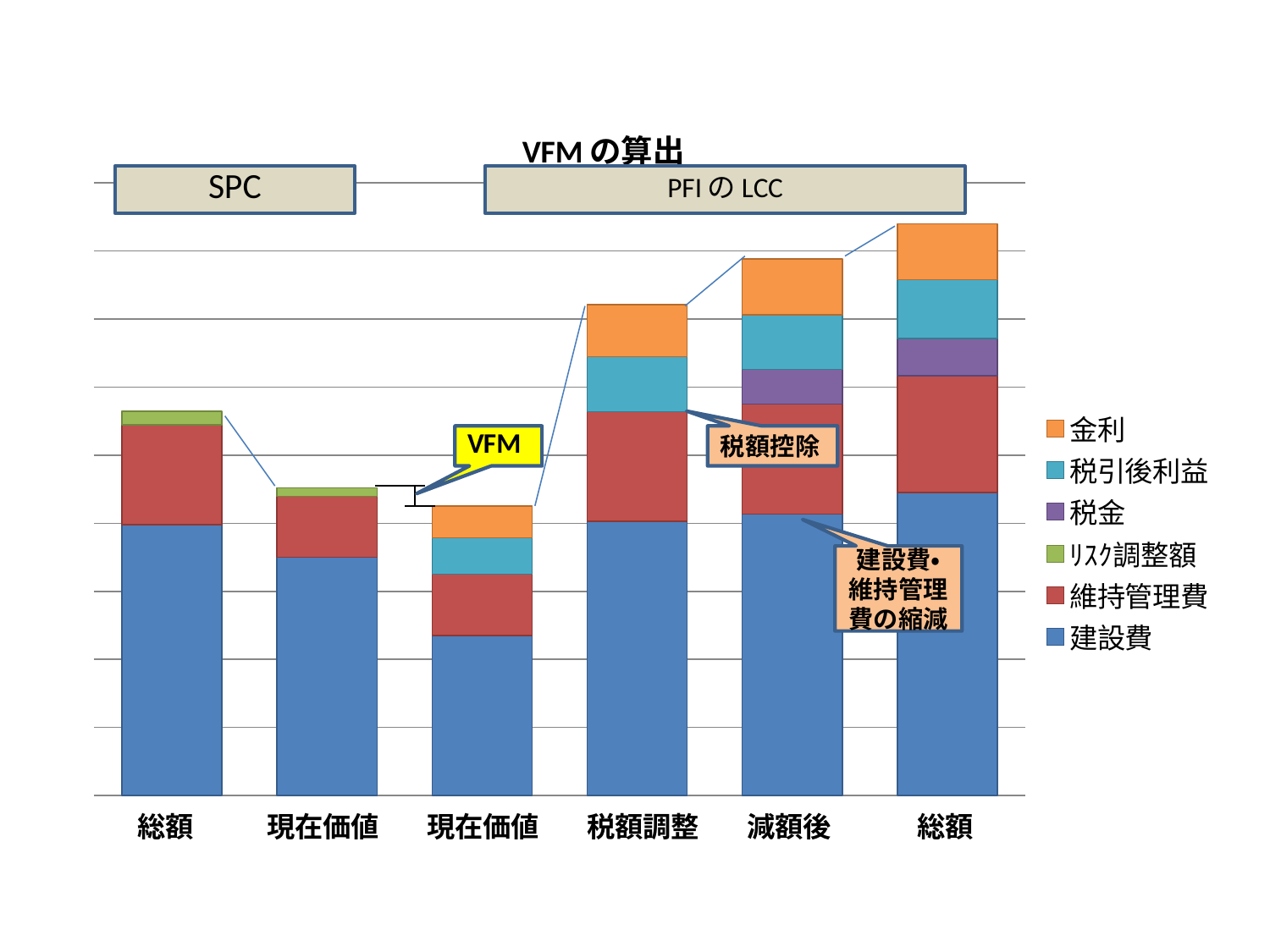
Which is taller: the second bar (現在価値) or the third bar (現在価値)? the second bar What is the title of the chart? VFM の算出 Which bar has the smallest total height? 現在価値 (third bar from the left) What kind of chart is shown on the slide? stacked bar chart Which series is shown in orange in the legend? 金利 How many bars are plotted along the x axis? 6 Which is taller: the 税額調整 bar or the 減額後 bar? 減額後 Do the bar totals rise or fall from the 税額調整 bar to the rightmost 総額 bar? rise Which is taller: the leftmost 総額 bar or the rightmost 総額 bar? the rightmost 総額 bar How many series does the legend list? 6 Which bar has the greatest total height? 総額 (rightmost bar)